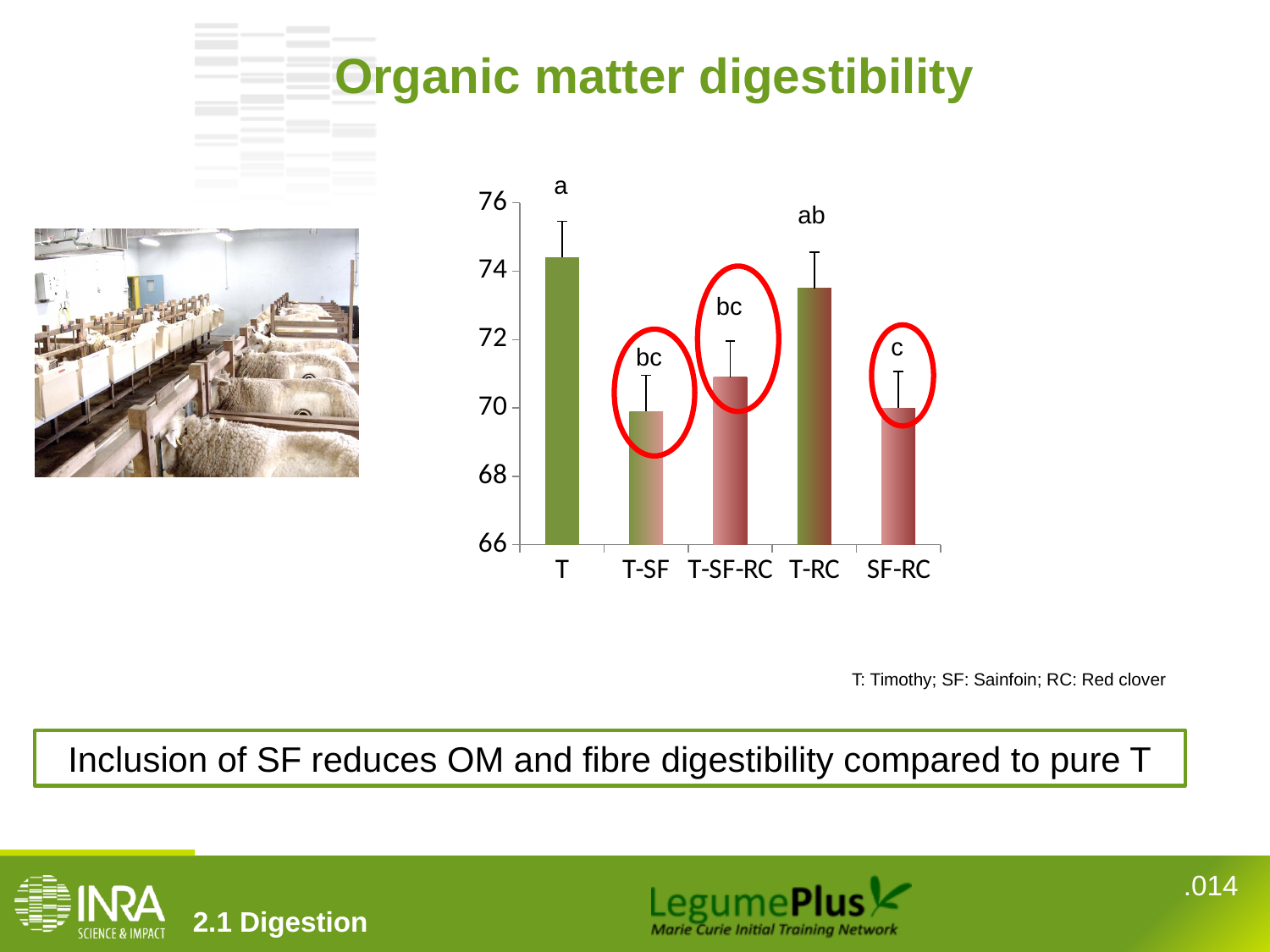
What is the title of the slide containing the chart? Organic matter digestibility Is the value for SF-RC greater or less than 72? less Is the value for T-SF greater or less than 72? less Which diet has the highest organic matter digestibility in the chart? T Which has the larger value, T or T-RC? T Is the value for T greater or less than 72? greater How many categories (diets) are shown on the x axis of the chart? 5 What significance letter is printed above the T bar in the chart? a Which has the larger value, T-SF-RC or T-SF? T-SF-RC What kind of chart is shown on the slide? bar chart